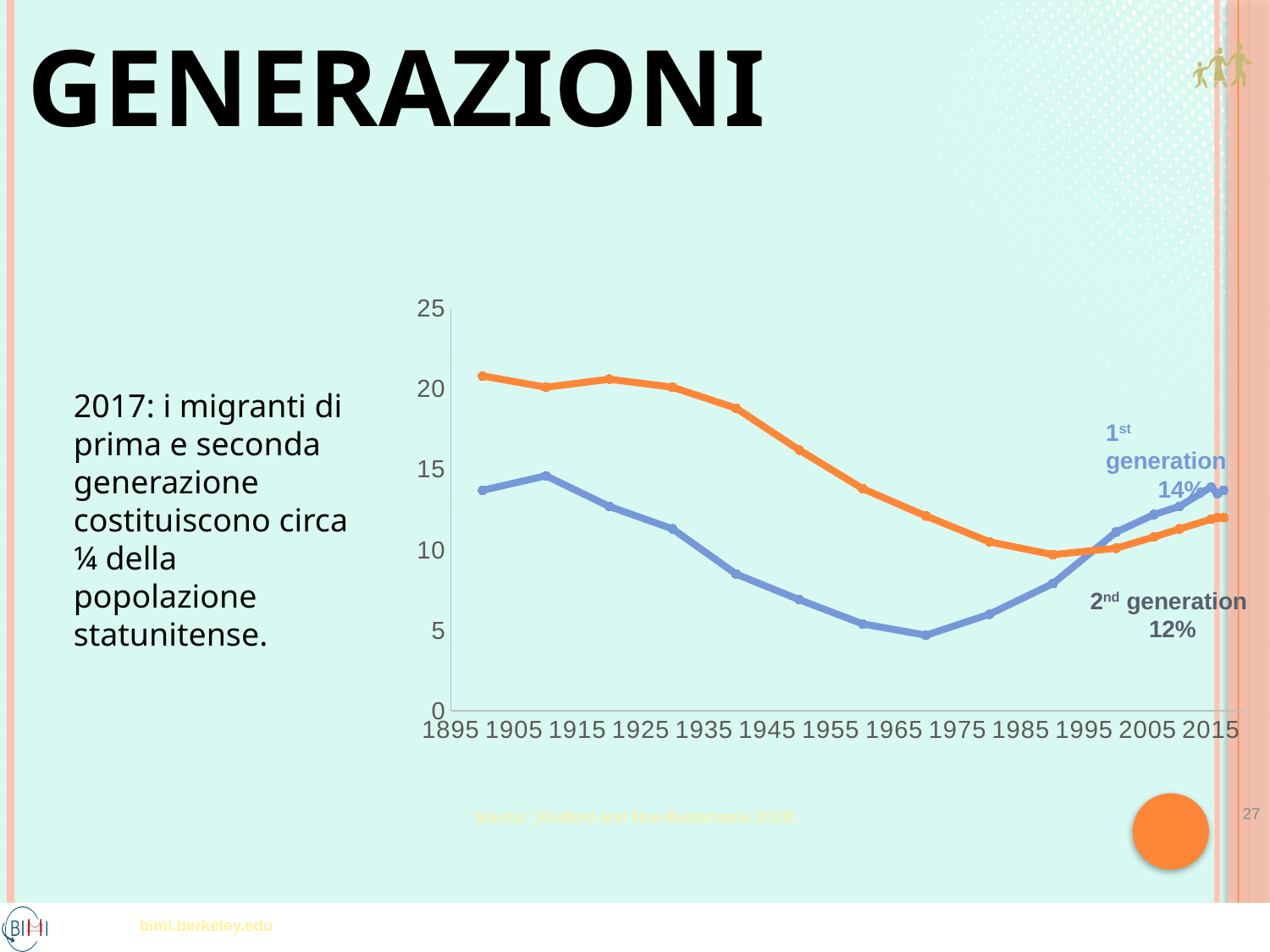
What is the difference between the final labelled values of the 1st generation (14%) and the 2nd generation (12%)? 2% Does the 2nd generation series rise or fall between 1900 and 1990? fall What is the labelled value for the 1st generation at the end of the series? 14% Is the value for the 1st generation around 1940 greater or less than 10? less At the end of the series, which is larger: the 1st generation or the 2nd generation? 1st generation Is the value for the 2nd generation around 1900 greater or less than 20? greater What is the labelled value for the 2nd generation at the end of the series? 12% How many data series are plotted on the chart? 2 Which colour is used for the 2nd generation line? orange What kind of chart is shown on the slide? line chart Around 1900, which series has the higher value: the 1st generation or the 2nd generation? 2nd generation